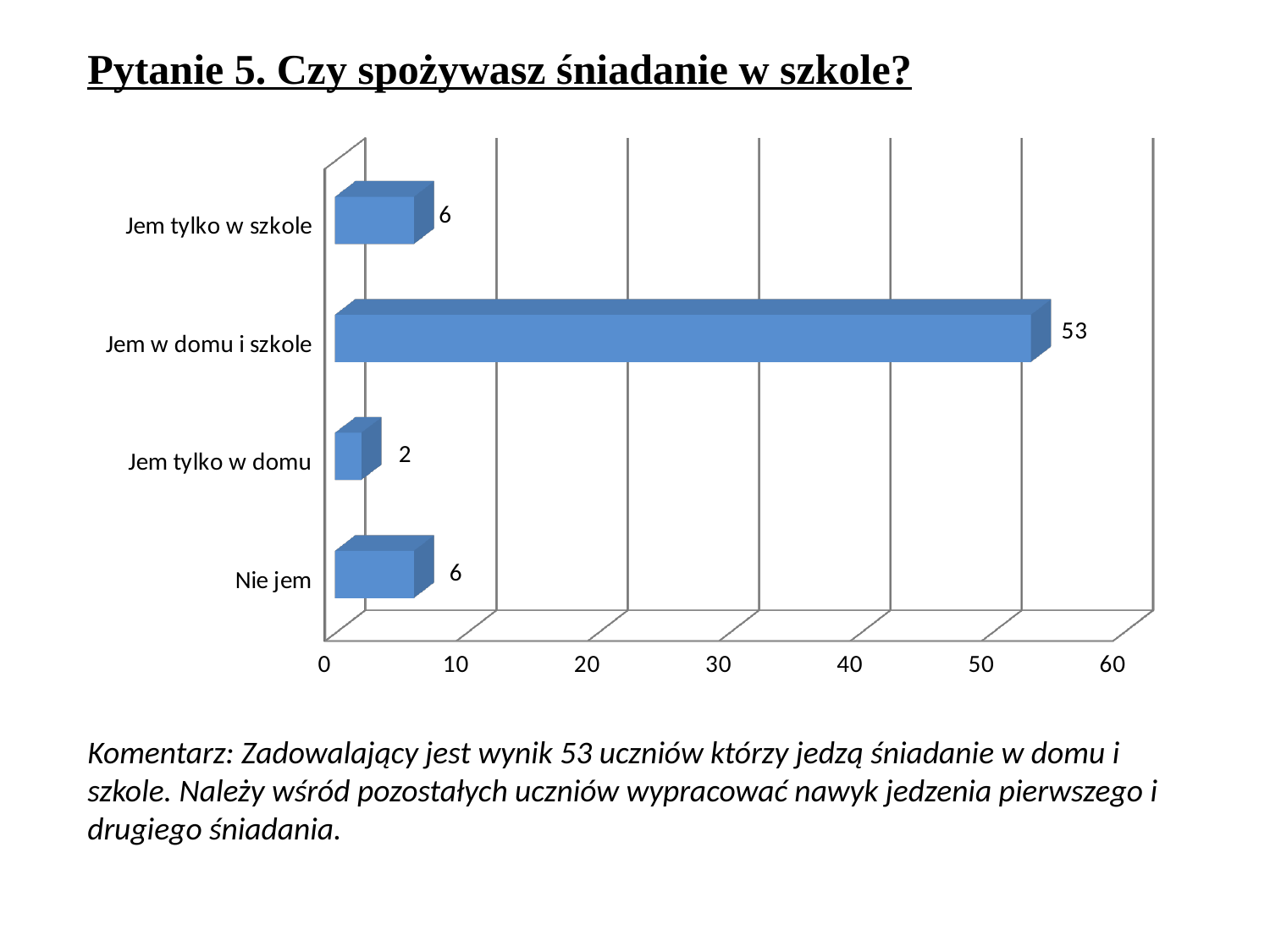
What is the value for "Nie jem"? 6 What is the value for "Jem tylko w szkole"? 6 What is the value for "Jem tylko w domu"? 2 Which category has the lowest value? Jem tylko w domu What kind of chart is shown on the slide? bar chart Is the value for "Jem w domu i szkole" greater or less than 50? greater Which is larger, the value for "Jem tylko w szkole" or the value for "Jem tylko w domu"? Jem tylko w szkole What is the difference between the values for "Jem tylko w szkole" and "Jem tylko w domu"? 4 What is the difference between the values for "Jem w domu i szkole" and "Nie jem"? 47 How many categories are shown in the chart? 4 Which category has the highest value? Jem w domu i szkole What is the value for "Jem w domu i szkole"? 53